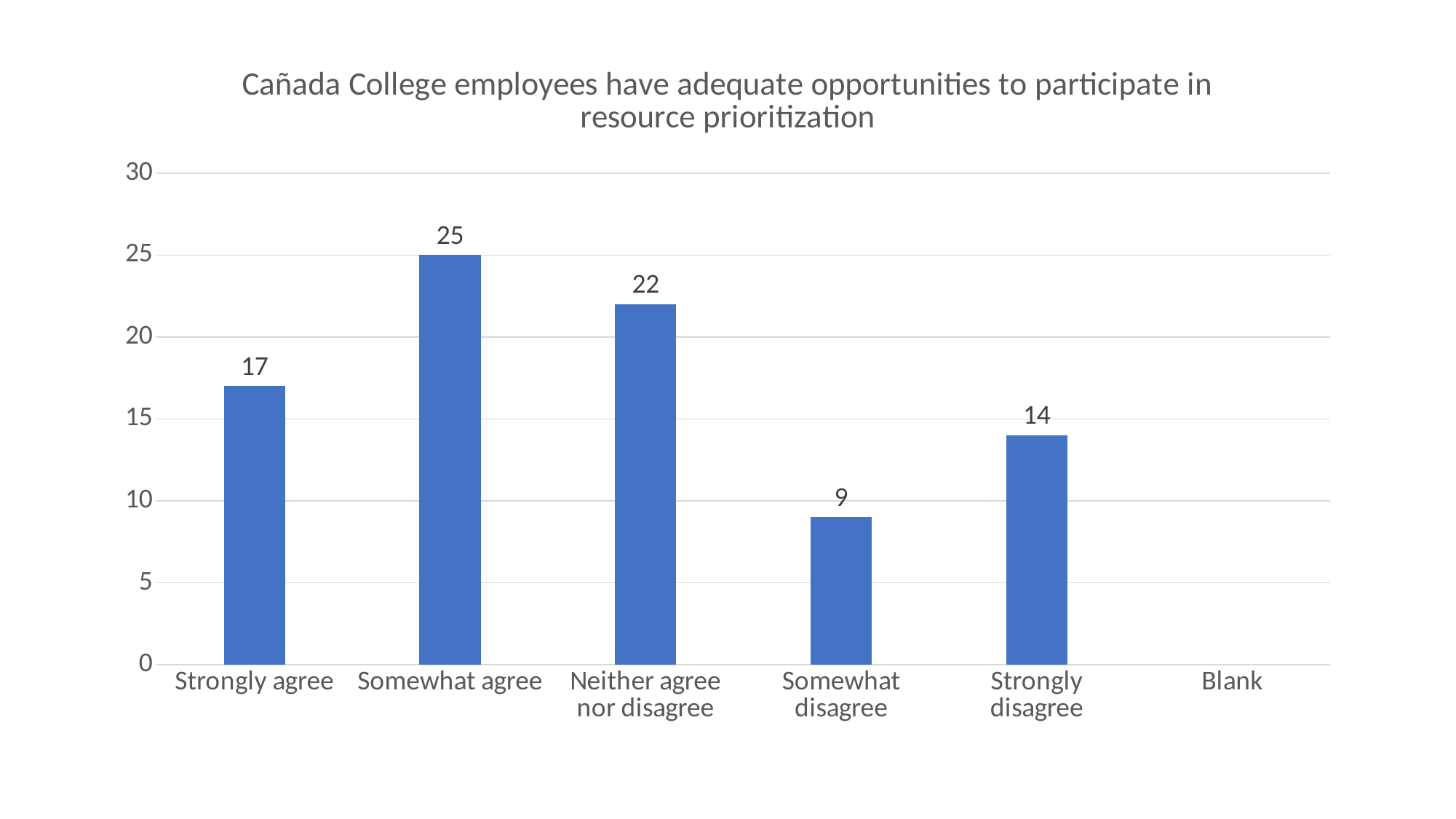
Which category has the highest value? Somewhat agree What kind of chart is this? bar chart Which is larger, the value for Strongly agree or the value for Strongly disagree? Strongly agree Is the value for Neither agree nor disagree greater or less than 20? greater What is the value for Strongly disagree? 14 How many categories are shown on the x axis? 6 What is the value for Somewhat agree? 25 Which category with a visible bar has the lowest value? Somewhat disagree What is the difference between the values for Strongly disagree and Somewhat disagree? 5 What is the value for Neither agree nor disagree? 22 What is the difference between the values for Somewhat agree and Strongly agree? 8 What is the title of the chart? Cañada College employees have adequate opportunities to participate in resource prioritization